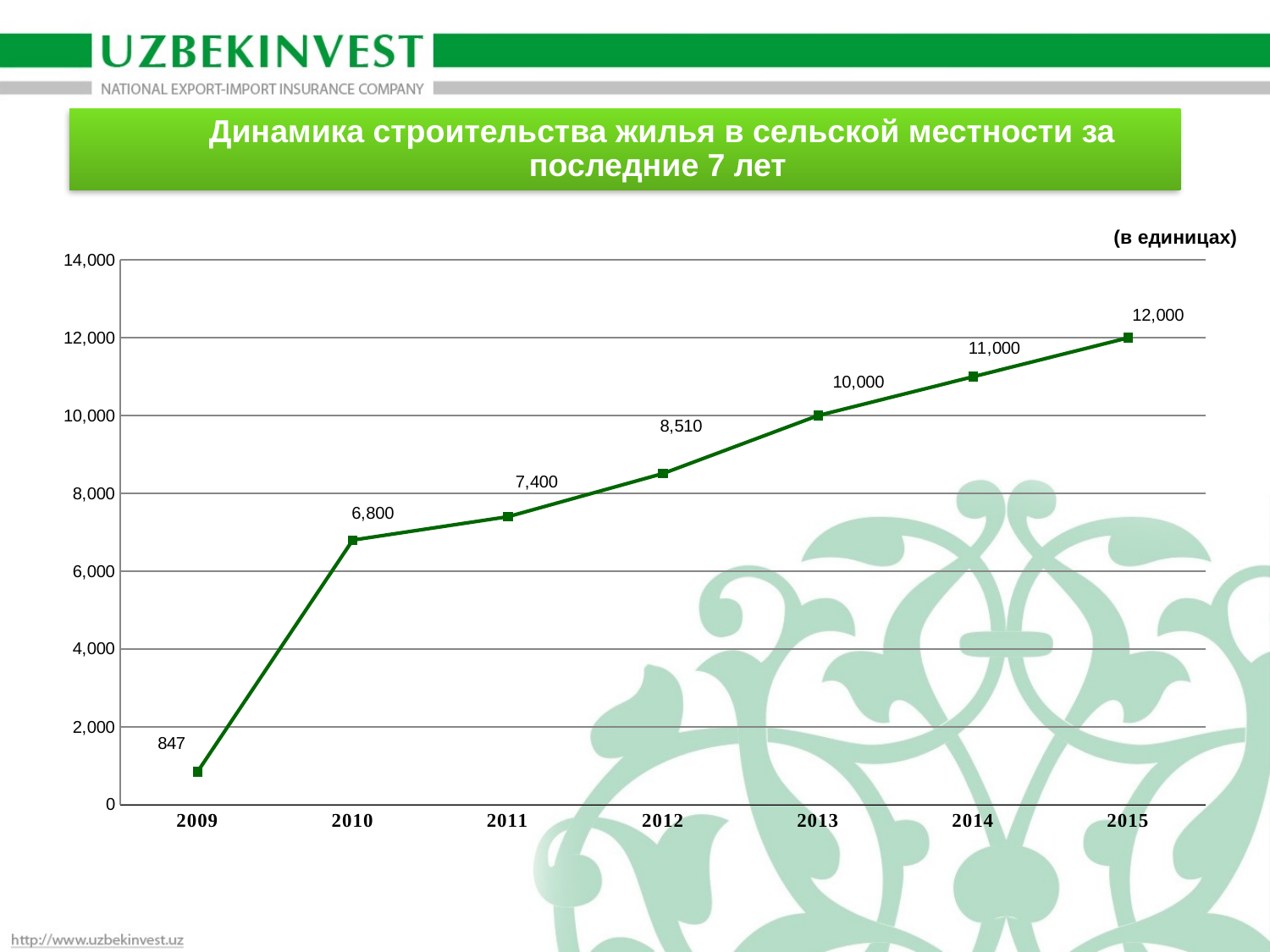
Which is larger, the value for 2013 or the value for 2012? 2013 What is the difference between the values for 2011 and 2010? 600 Which year has the lowest value? 2009 Do the values rise or fall from 2009 to 2015? rise What is the value for 2014? 11,000 What kind of chart is shown on the slide? line chart What is the value for 2012? 8,510 Which year has the highest value? 2015 What is the value for 2009? 847 How many years are plotted on the chart? 7 Is the value for 2010 greater or less than 6,000? greater What is the difference between the values for 2015 and 2009? 11,153